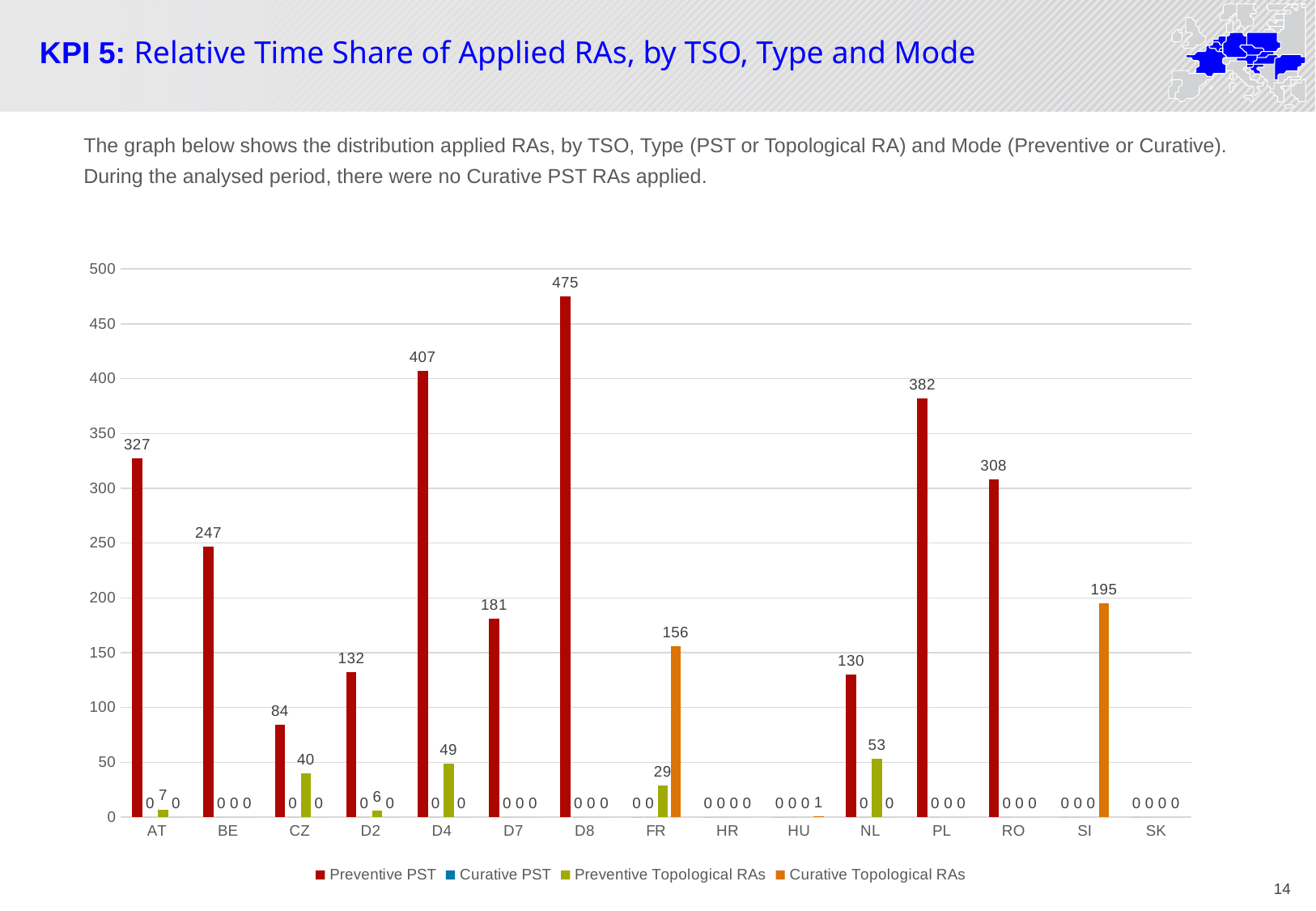
What kind of chart is shown on the slide? Bar chart Is the Preventive PST value for AT greater or less than 300? greater What is the Curative Topological RAs value for FR? 156 Which is larger, the Preventive PST value for BE or for RO? RO How many series does the legend list? 4 Which series is shown in orange in the legend? Curative Topological RAs What is the Preventive PST value for D8? 475 Which TSO has the highest Preventive PST value? D8 What is the Preventive Topological RAs value for NL? 53 How many TSO categories are shown on the x axis? 15 What is the difference between the Preventive PST values for D4 and PL? 25 Which TSO has the highest Curative Topological RAs value? SI